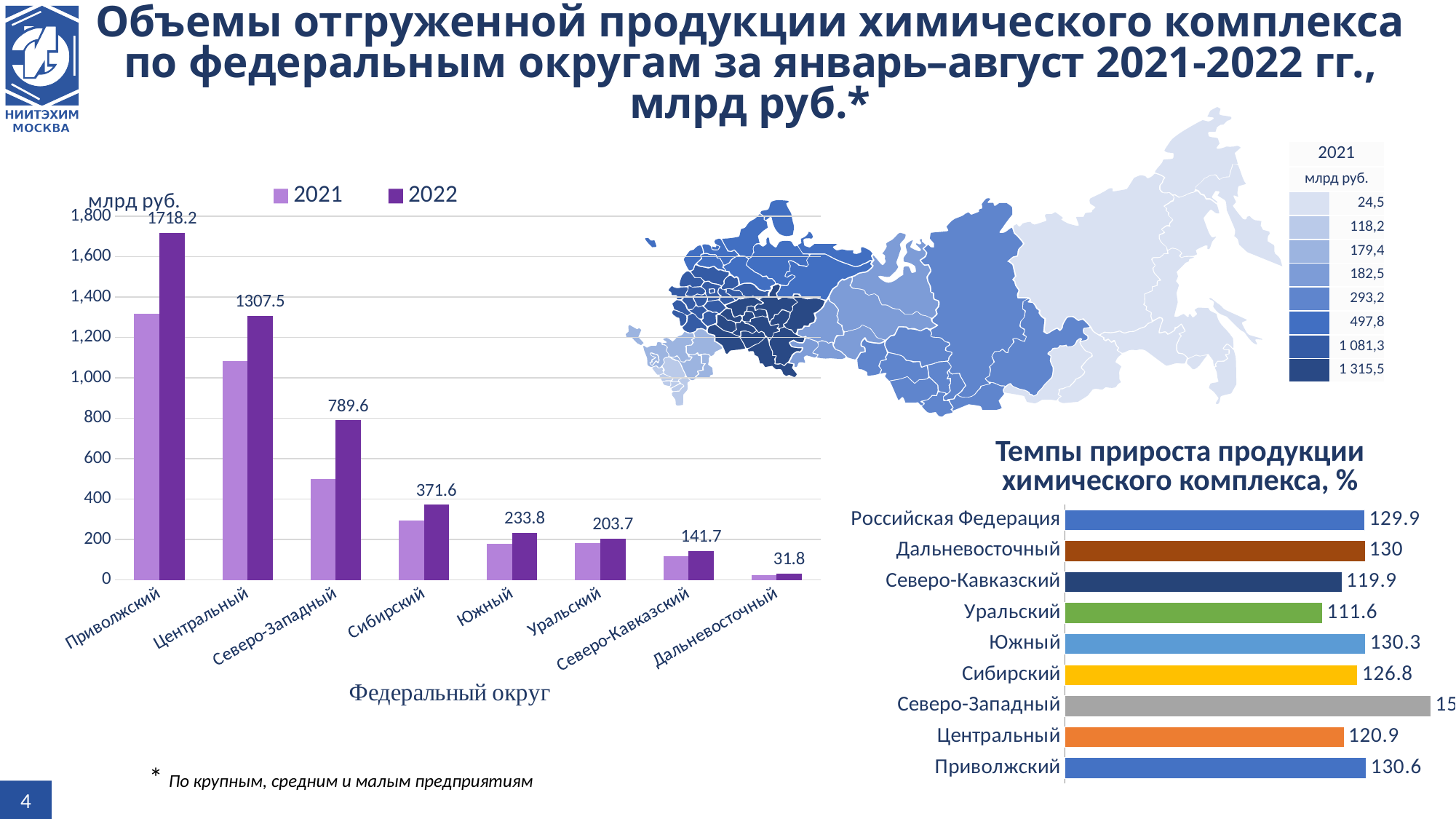
How many series does the legend of the left bar chart list? 2 In the left bar chart, what is the 2022 value for Приволжский? 1718.2 In the left bar chart, what is the difference between the 2022 values for Центральный and Северо-Западный? 517.9 In the chart 'Темпы прироста продукции химического комплекса, %', what is the value for Сибирский? 126.8 In the chart 'Темпы прироста продукции химического комплекса, %', which is larger: the value for Центральный or the value for Северо-Кавказский? Центральный In the left bar chart, is the 2021 value for Приволжский greater or less than 1,200? greater How many federal districts are shown on the x axis of the left bar chart? 8 In the chart 'Темпы прироста продукции химического комплекса, %', which category has the lowest value? Уральский What kind of chart is 'Темпы прироста продукции химического комплекса, %'? bar chart In the left bar chart, is the 2021 value for Северо-Западный greater or less than 600? less In the left bar chart, what is the 2022 value for Северо-Западный? 789.6 In the left bar chart, which federal district has the lowest 2022 value? Дальневосточный